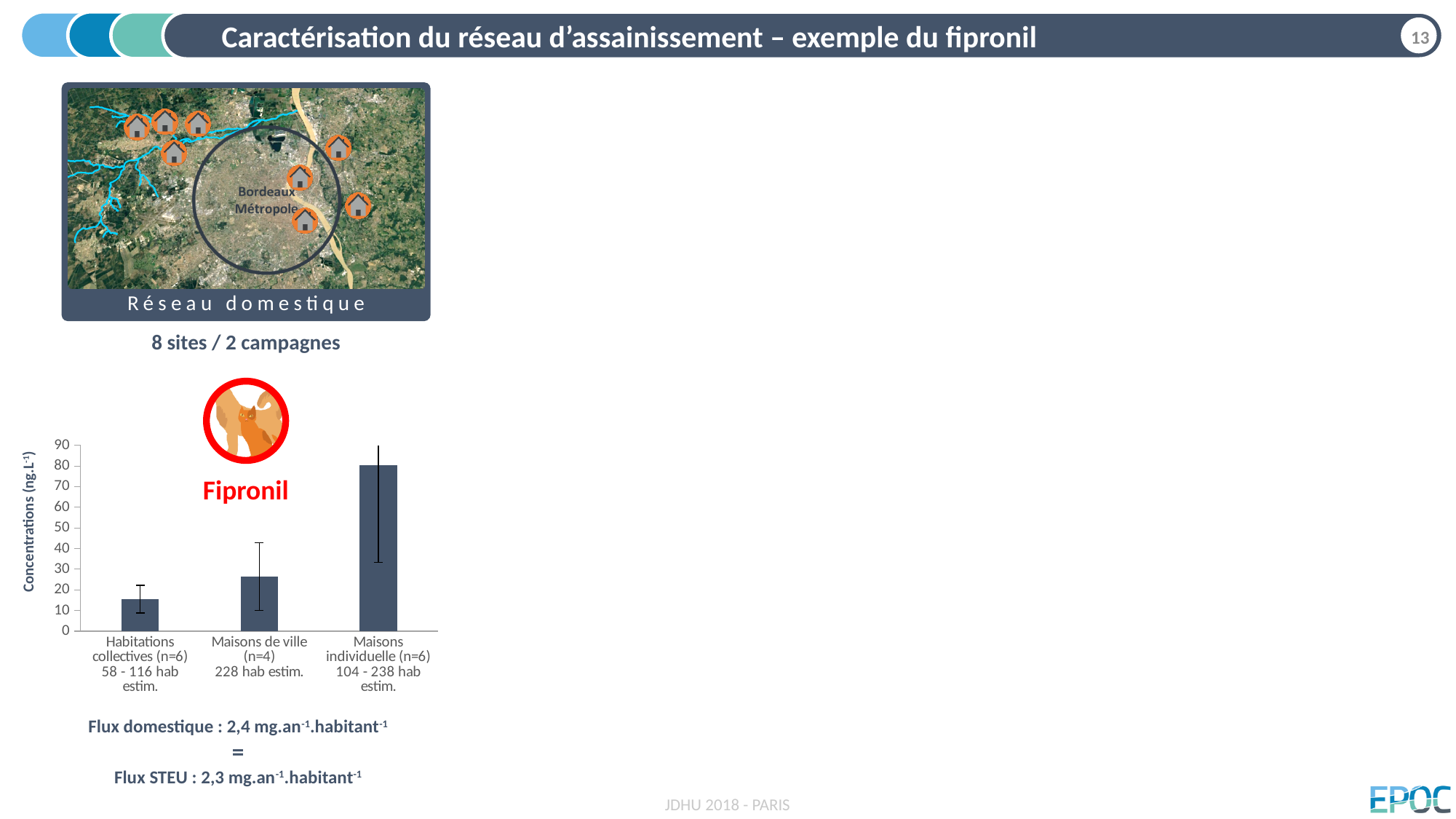
Is the concentration for Habitations collectives (n=6) greater or less than 20? less Is the concentration for Maisons individuelle (n=6) greater or less than 50? greater How many categories are plotted on the x axis of the bar chart? 3 Which has the larger concentration: Maisons de ville (n=4) or Habitations collectives (n=6)? Maisons de ville (n=4) What is the label of the y axis of the bar chart? Concentrations (ng.L-1) Is the concentration for Maisons de ville (n=4) greater or less than 30? less Do the bar values rise or fall from left to right along the x axis? rise Which compound do the concentrations in the bar chart refer to? Fipronil Which category has the highest concentration in the bar chart? Maisons individuelle (n=6) What kind of chart is shown on the slide? bar chart Which category has the lowest concentration in the bar chart? Habitations collectives (n=6)